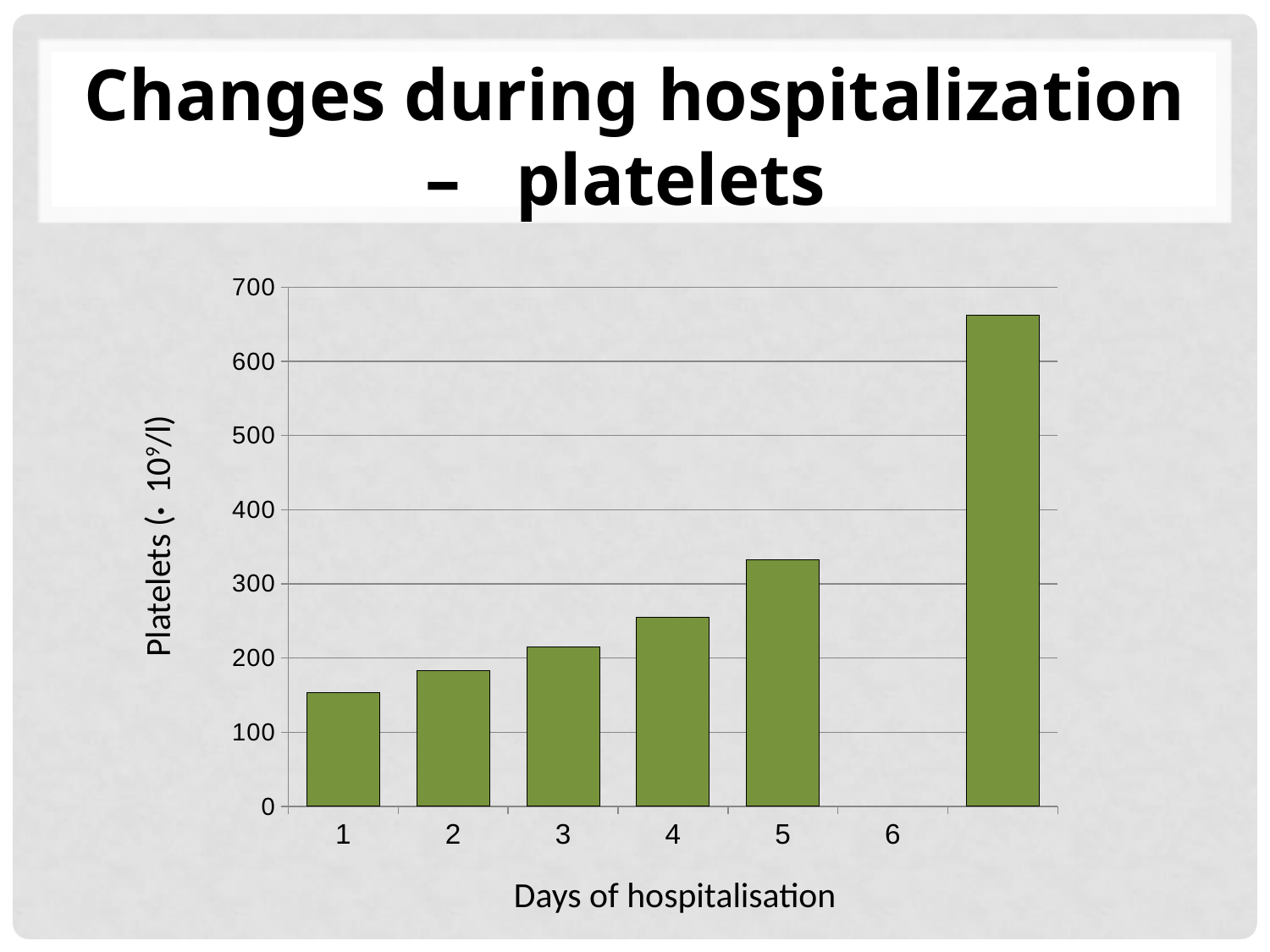
What kind of chart is shown on the slide? bar chart How many day labels are shown on the x axis? 6 Is the platelet value for day 1 greater or less than 200? less What is the highest tick value shown on the y axis? 700 What is the title of the x axis? Days of hospitalisation Is the platelet value for day 3 greater or less than 200? greater Is the value of the tallest bar greater or less than 600? greater Which day of hospitalisation has the lowest platelet count? 1 Which has the higher platelet count, day 4 or day 5? day 5 Do the platelet values rise or fall from day 1 to day 5? rise